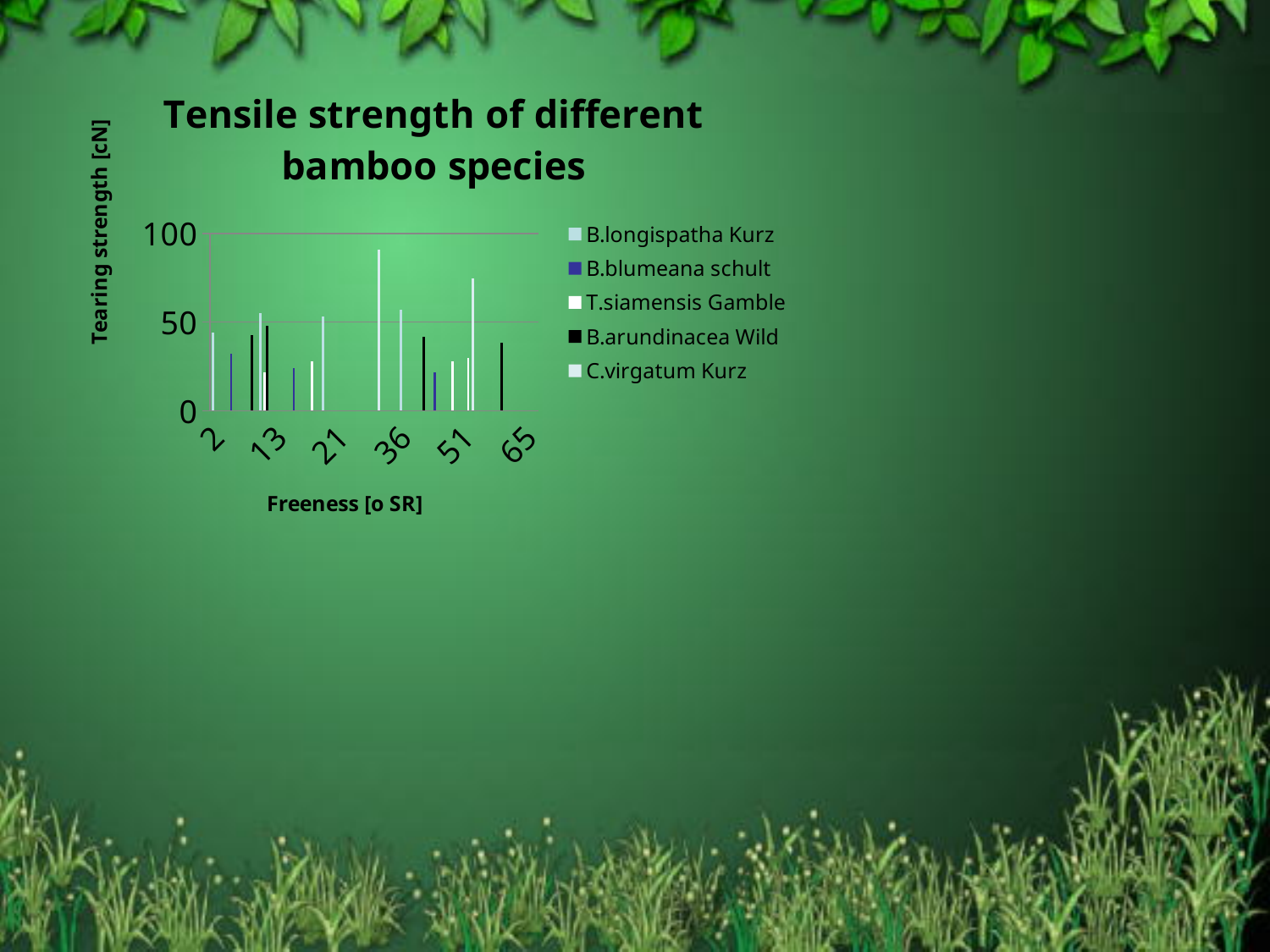
Is the tallest bar at freeness 51 greater or less than 50? greater What is the first series listed in the chart's legend? B.longispatha Kurz What is the title of the chart? Tensile strength of different bamboo species Is the tallest bar at freeness 2 greater or less than 50? less How many series does the legend of the chart list? 5 Is the tallest bar at freeness 36 greater or less than 50? greater How many freeness categories are shown on the x axis of the chart? 6 What kind of chart is shown on the slide? bar chart